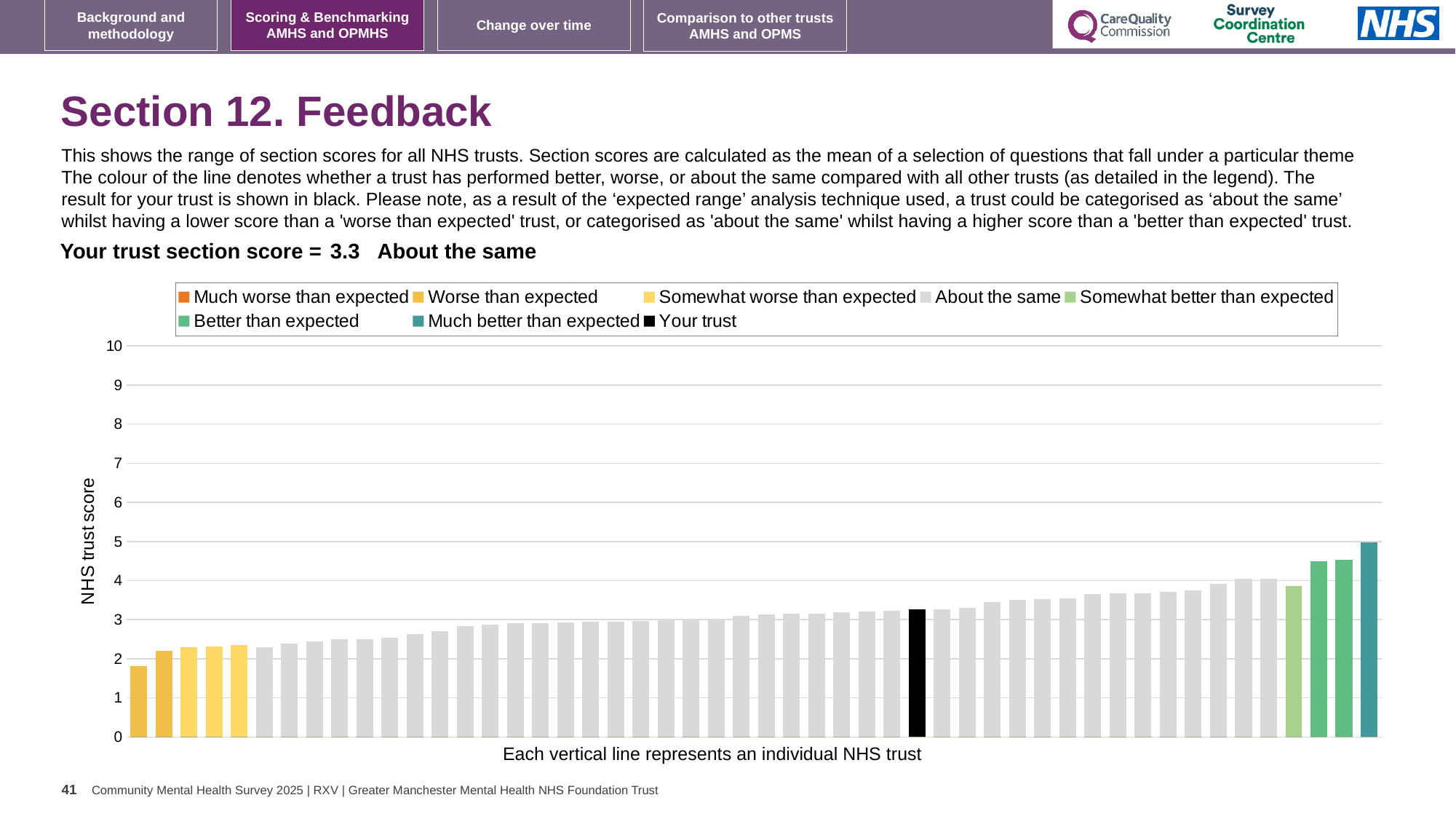
Which performance category is your trust placed in for Section 12. Feedback? About the same Do the bar values rise or fall moving from left to right along the x axis? Rise Is the value of the black 'Your trust' bar greater or less than 3? greater What colour is used for the 'Your trust' bar in the chart? Black Is the value of the leftmost bar in the chart greater or less than 2? less What is the label on the vertical axis of the chart? NHS trust score How many bars are coloured as 'Better than expected' (green)? 2 What kind of chart is shown on the slide? Bar chart What is the section score for your trust shown on the slide? 3.3 How many entries does the chart legend list? 8 Is the value of the tallest bar in the chart greater or less than 4? greater Which legend category does the tallest bar on the right belong to? Much better than expected